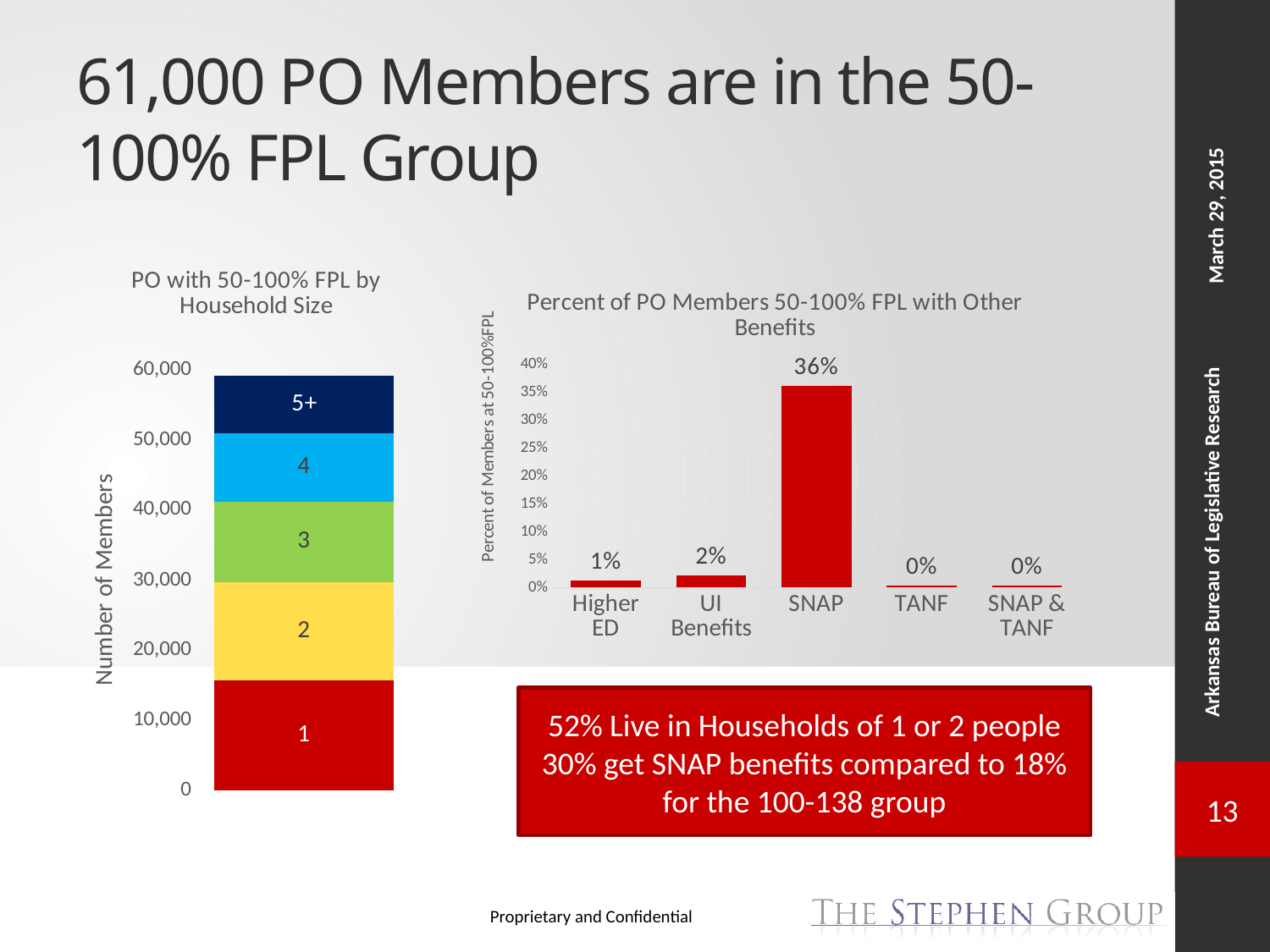
In the chart 'Percent of PO Members 50-100% FPL with Other Benefits', what is the value for UI Benefits? 2% In the chart 'Percent of PO Members 50-100% FPL with Other Benefits', what is the value for Higher ED? 1% In the chart 'Percent of PO Members 50-100% FPL with Other Benefits', which is larger, the value for UI Benefits or the value for Higher ED? UI Benefits What kind of chart is 'Percent of PO Members 50-100% FPL with Other Benefits'? Bar chart How many household-size segments are stacked in the chart 'PO with 50-100% FPL by Household Size'? 5 In the chart 'Percent of PO Members 50-100% FPL with Other Benefits', what is the value for SNAP? 36% In the chart 'Percent of PO Members 50-100% FPL with Other Benefits', what is the difference between the SNAP value and the UI Benefits value? 34% What is the y-axis title of the chart 'PO with 50-100% FPL by Household Size'? Number of Members How many categories are shown in the chart 'Percent of PO Members 50-100% FPL with Other Benefits'? 5 In the chart 'PO with 50-100% FPL by Household Size', is the number of members in household size 1 greater or less than 10,000? greater In the chart 'Percent of PO Members 50-100% FPL with Other Benefits', is the value for SNAP greater or less than 30%? greater In the chart 'Percent of PO Members 50-100% FPL with Other Benefits', which category has the highest value? SNAP